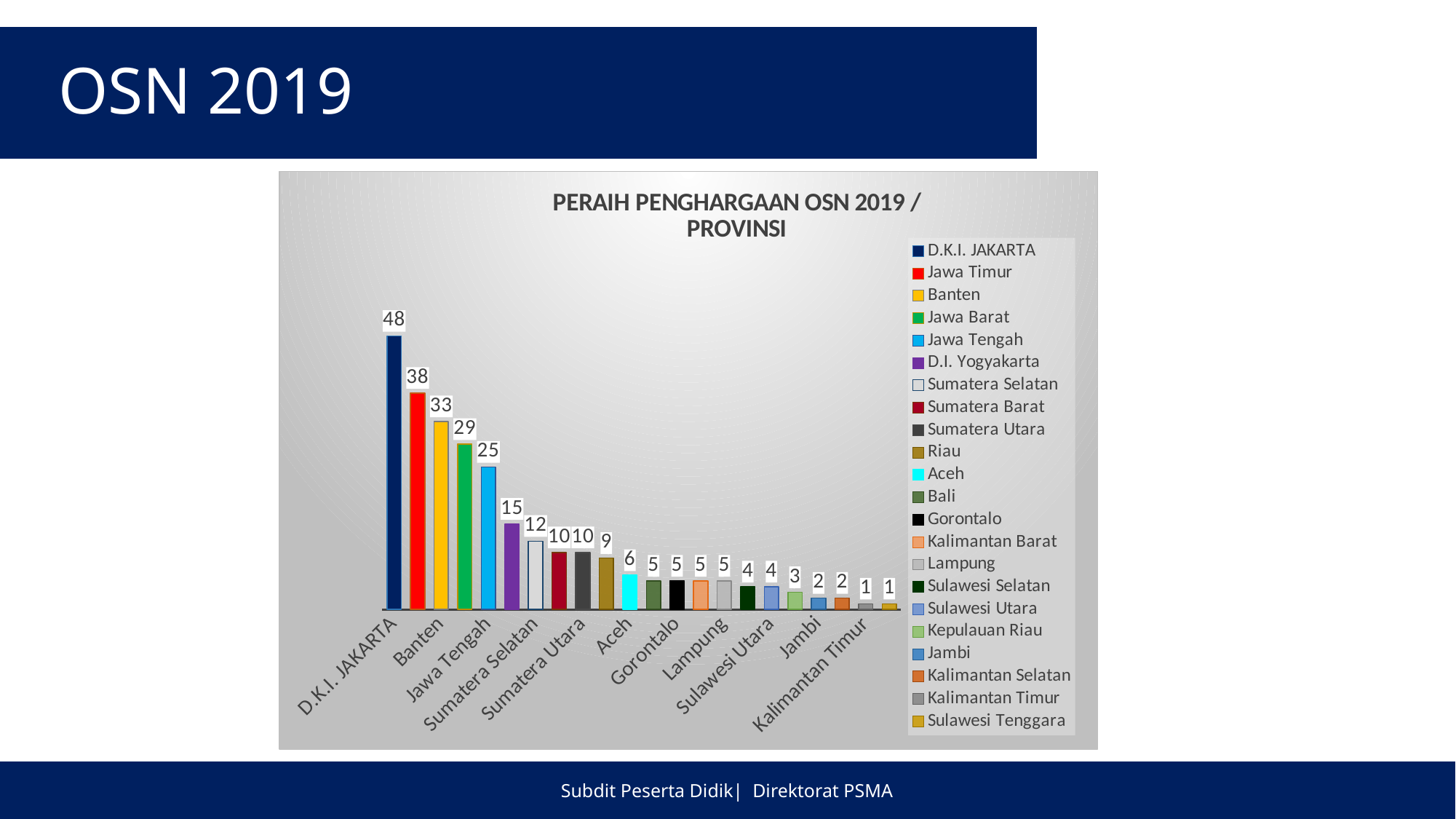
How many provinces are plotted in the chart? 22 What is the value for Kepulauan Riau? 3 Which is larger, the value for D.I. Yogyakarta or the value for Sumatera Selatan? D.I. Yogyakarta What is the difference between the values for D.K.I. JAKARTA and Jawa Timur? 10 What is the value for D.K.I. JAKARTA? 48 How many entries does the legend list? 22 What is the difference between the values for Banten and Jawa Barat? 4 What is the value for Aceh? 6 What is the value for Jawa Tengah? 25 What kind of chart is shown on the slide? bar chart What is the title of the chart? PERAIH PENGHARGAAN OSN 2019 / PROVINSI Which province has the highest value? D.K.I. JAKARTA